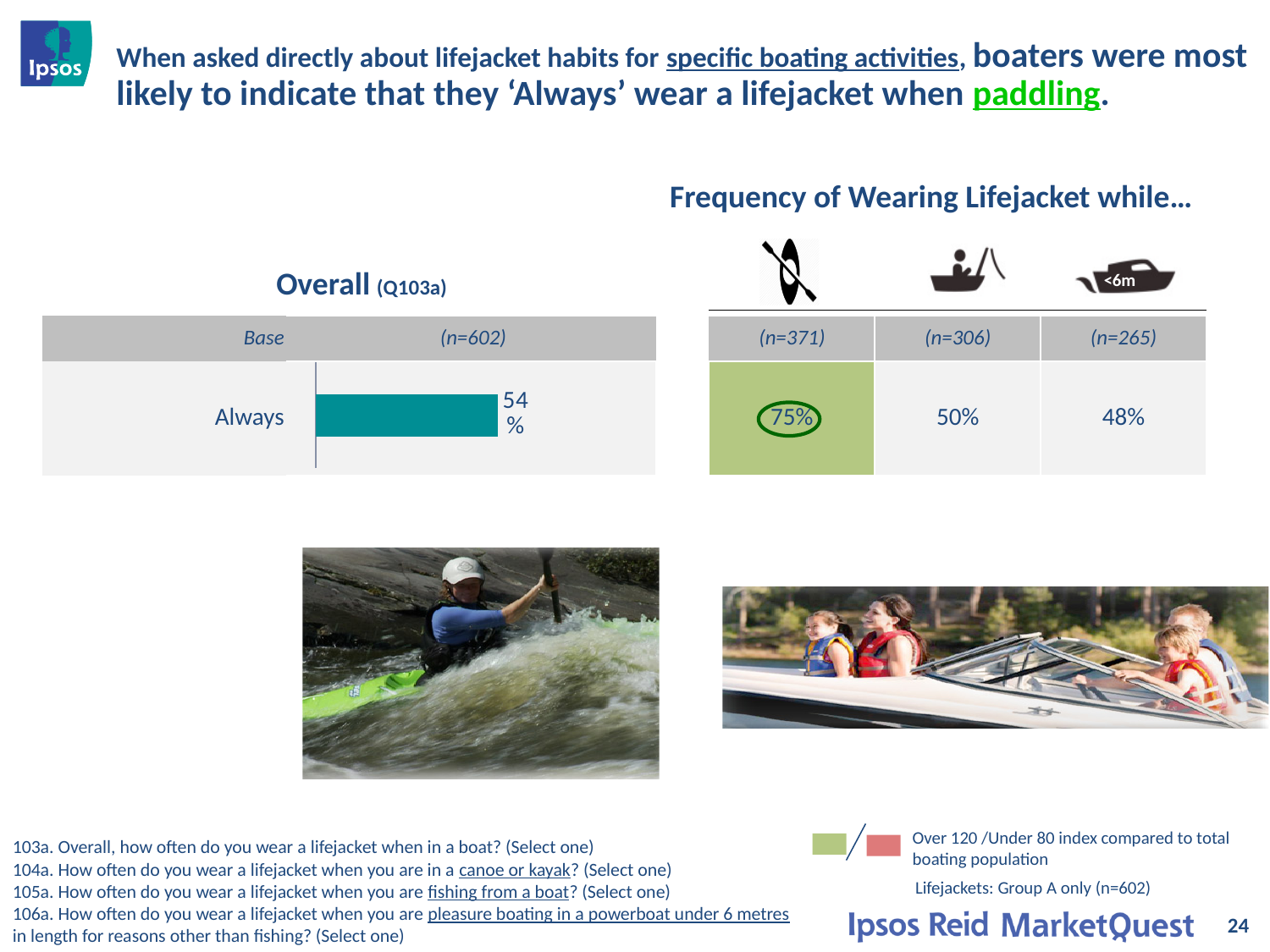
How many bars are plotted in the Overall (Q103a) chart? 1 Which activity in the 'Frequency of Wearing Lifejacket while…' table has the highest 'Always' percentage? canoe/kayak (75%) What is the difference between the canoe/kayak 'Always' value (75%) and the Overall 'Always' value (54%) shown on the slide? 21 percentage points What is the base size (n) shown for the Overall (Q103a) chart? n=602 In the Overall (Q103a) chart, what is the value shown for 'Always'? 54% What is the category label of the bar in the Overall (Q103a) chart? Always Which activity in the 'Frequency of Wearing Lifejacket while…' table has the lowest 'Always' percentage? powerboat under 6m (48%) What kind of chart is the Overall (Q103a) chart? bar chart Is the 'Always' value in the Overall (Q103a) chart greater or less than 50? greater Which is larger: the 'Always' value in the Overall (Q103a) chart (54%) or the canoe/kayak 'Always' value in the table (75%)? canoe/kayak (75%)